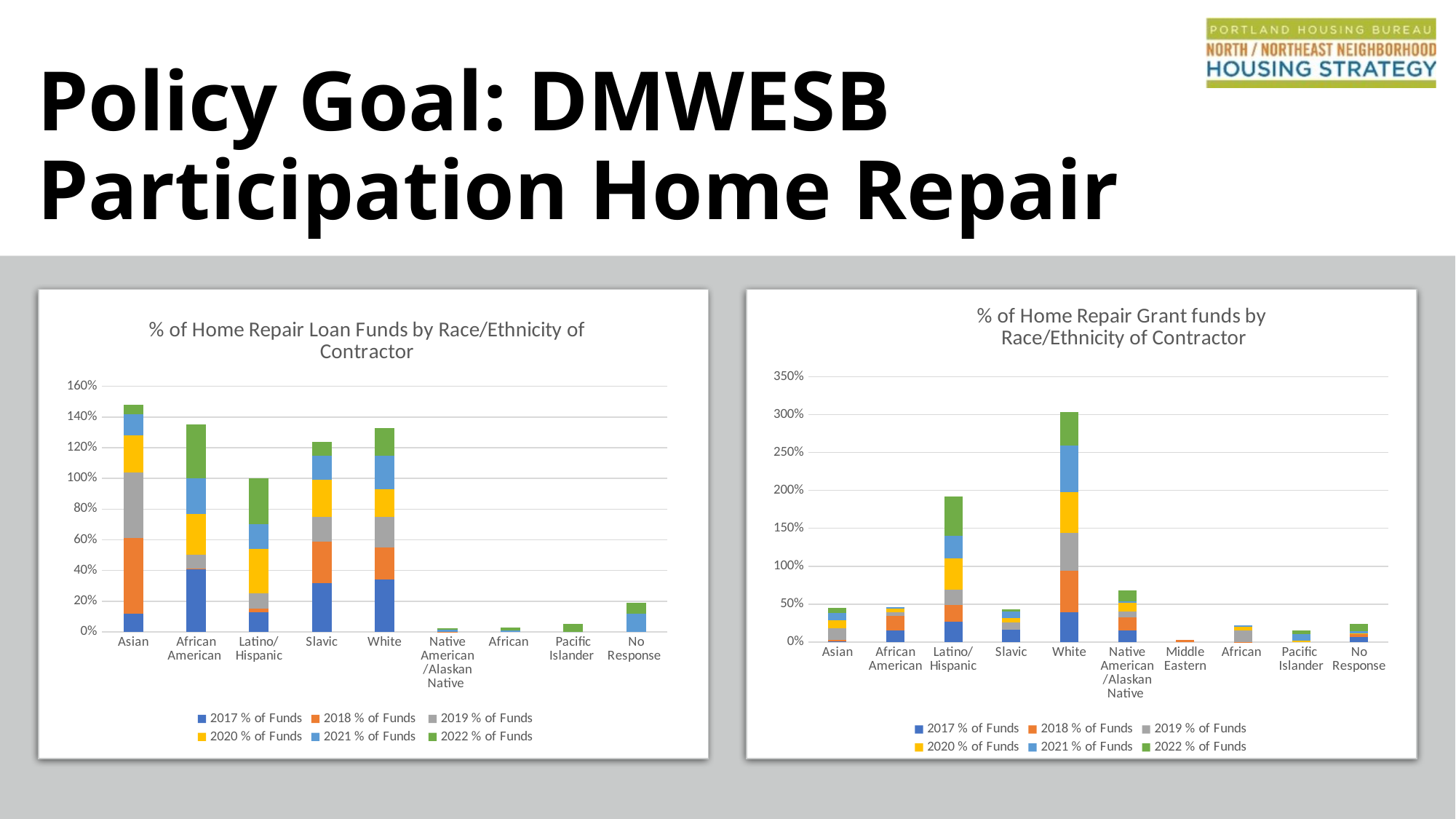
In the left chart, '% of Home Repair Loan Funds by Race/Ethnicity of Contractor', which category has the tallest stacked bar? Asian Which legend entry in the left chart, '% of Home Repair Loan Funds by Race/Ethnicity of Contractor', is shown in green? 2022 % of Funds How many series does the legend of the right chart, '% of Home Repair Grant funds by Race/Ethnicity of Contractor', list? 6 In the right chart, '% of Home Repair Grant funds by Race/Ethnicity of Contractor', which category has the shortest stacked bar? Middle Eastern In the right chart, '% of Home Repair Grant funds by Race/Ethnicity of Contractor', is the total stacked value for White greater or less than 250%? greater In the right chart, '% of Home Repair Grant funds by Race/Ethnicity of Contractor', which category has the tallest stacked bar? White In the left chart, '% of Home Repair Loan Funds by Race/Ethnicity of Contractor', is the total stacked value for Asian greater or less than 140%? greater How many race/ethnicity categories are shown on the x axis of the left chart, '% of Home Repair Loan Funds by Race/Ethnicity of Contractor'? 9 How many race/ethnicity categories are shown on the x axis of the right chart, '% of Home Repair Grant funds by Race/Ethnicity of Contractor'? 10 In the right chart, '% of Home Repair Grant funds by Race/Ethnicity of Contractor', is the total stacked value for Latino/Hispanic greater or less than 150%? greater What kind of chart is the left chart, '% of Home Repair Loan Funds by Race/Ethnicity of Contractor'? Stacked bar chart In the left chart, '% of Home Repair Loan Funds by Race/Ethnicity of Contractor', which has the taller stacked bar: Asian or Slavic? Asian